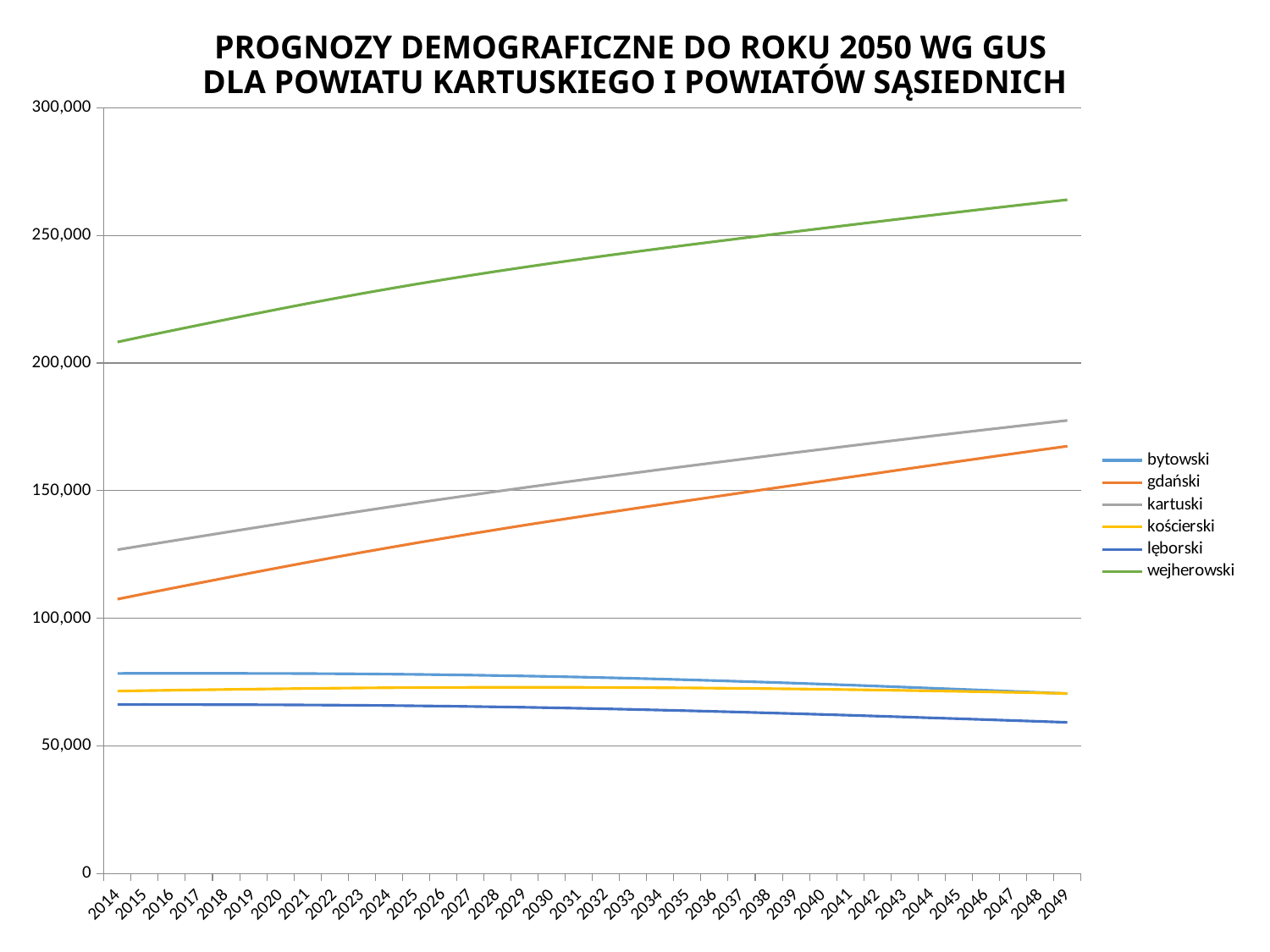
How many years are shown along the x axis? 36 Which series has the lowest values across the whole chart? lęborski How many series does the legend list? 6 Is the value for gdański in 2014 greater or less than 100,000? greater Does the wejherowski series rise or fall from 2014 to 2049? rise Does the lęborski series rise or fall from 2014 to 2049? fall What colour is the wejherowski line in the legend? green What kind of chart is shown on the slide? line chart Which series has the highest values across the whole chart? wejherowski Is the value for wejherowski in 2014 greater or less than 200,000? greater In 2049, which is larger: kartuski or gdański? kartuski Is the value for kartuski in 2049 greater or less than 150,000? greater